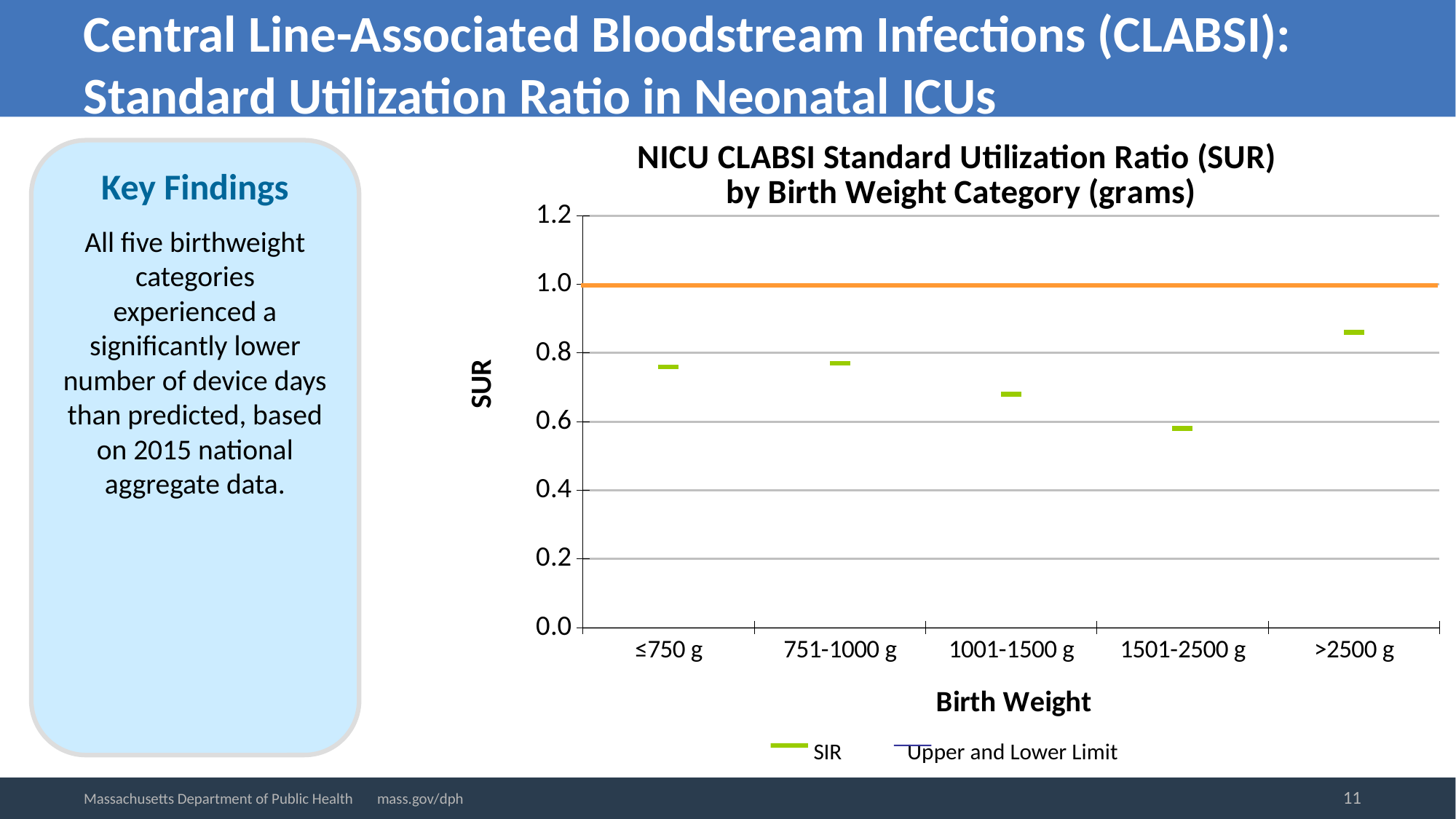
Which birth weight category has the lowest SIR value on the chart? 1501-2500 g Is the SIR value for >2500 g greater or less than 0.8? greater What is the title of the chart? NICU CLABSI Standard Utilization Ratio (SUR) by Birth Weight Category (grams) Which birth weight category has the highest SIR value on the chart? >2500 g Which has the larger SIR value, 1501-2500 g or ≤750 g? ≤750 g Is the SIR value for ≤750 g greater or less than 0.8? less Is the SIR value for 1001-1500 g greater or less than 0.6? greater Which has the larger SIR value, 1001-1500 g or >2500 g? >2500 g How many series does the chart legend list? 2 What is the label of the y axis? SUR How many birth weight categories are shown on the x axis? 5